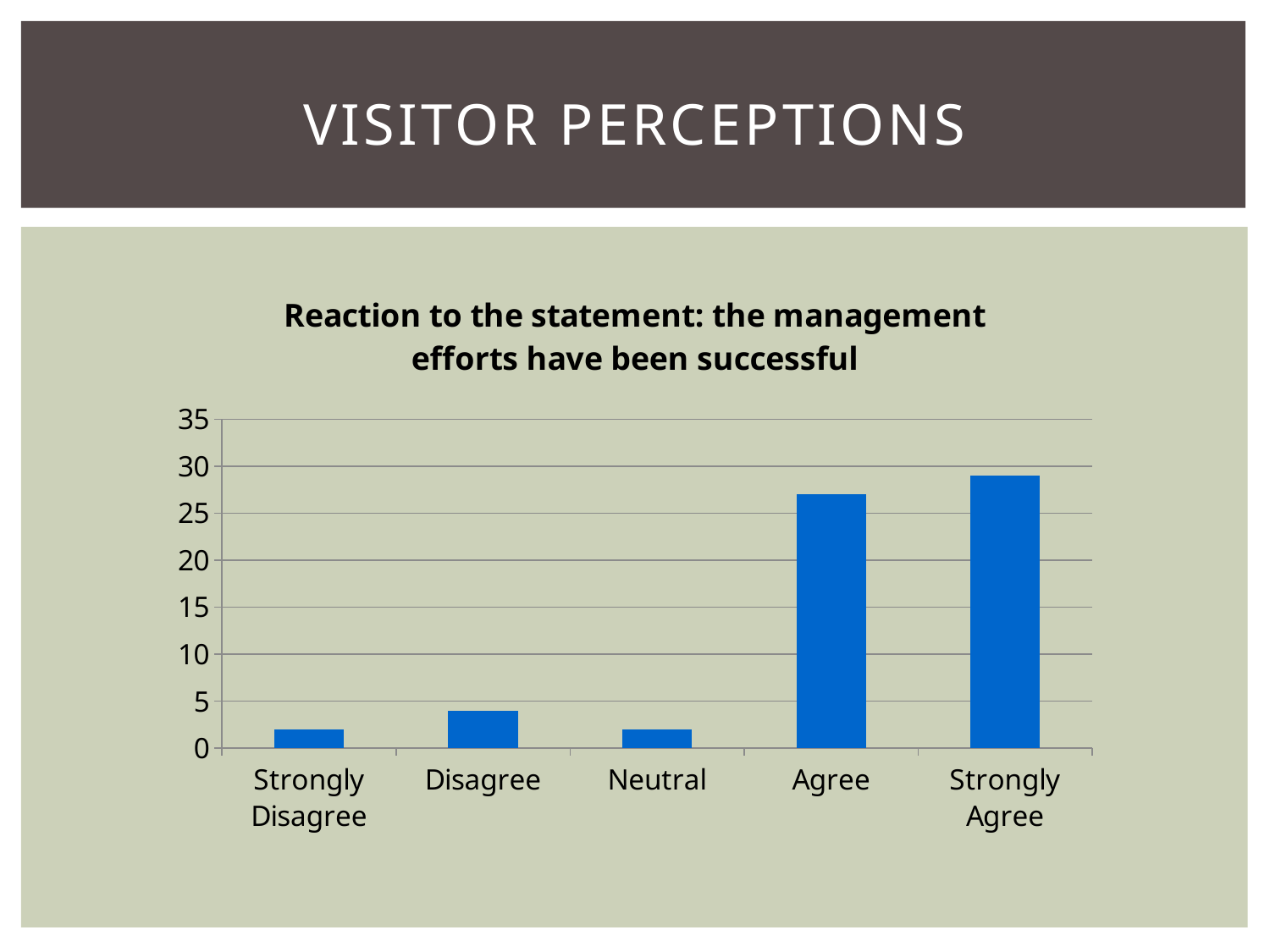
What is the highest value shown on the y axis of the chart? 35 Is the value for Strongly Disagree greater or less than 5? less Which category has the highest value in the chart? Strongly Agree Is the value for Strongly Agree greater or less than 30? less Is the value for Disagree greater or less than 5? less What kind of chart is shown on the slide? bar chart How many categories are shown on the x axis of the chart? 5 Which is larger, the value for Neutral or the value for Strongly Agree? Strongly Agree Which is larger, the value for Agree or the value for Disagree? Agree What is the title of the chart? Reaction to the statement: the management efforts have been successful